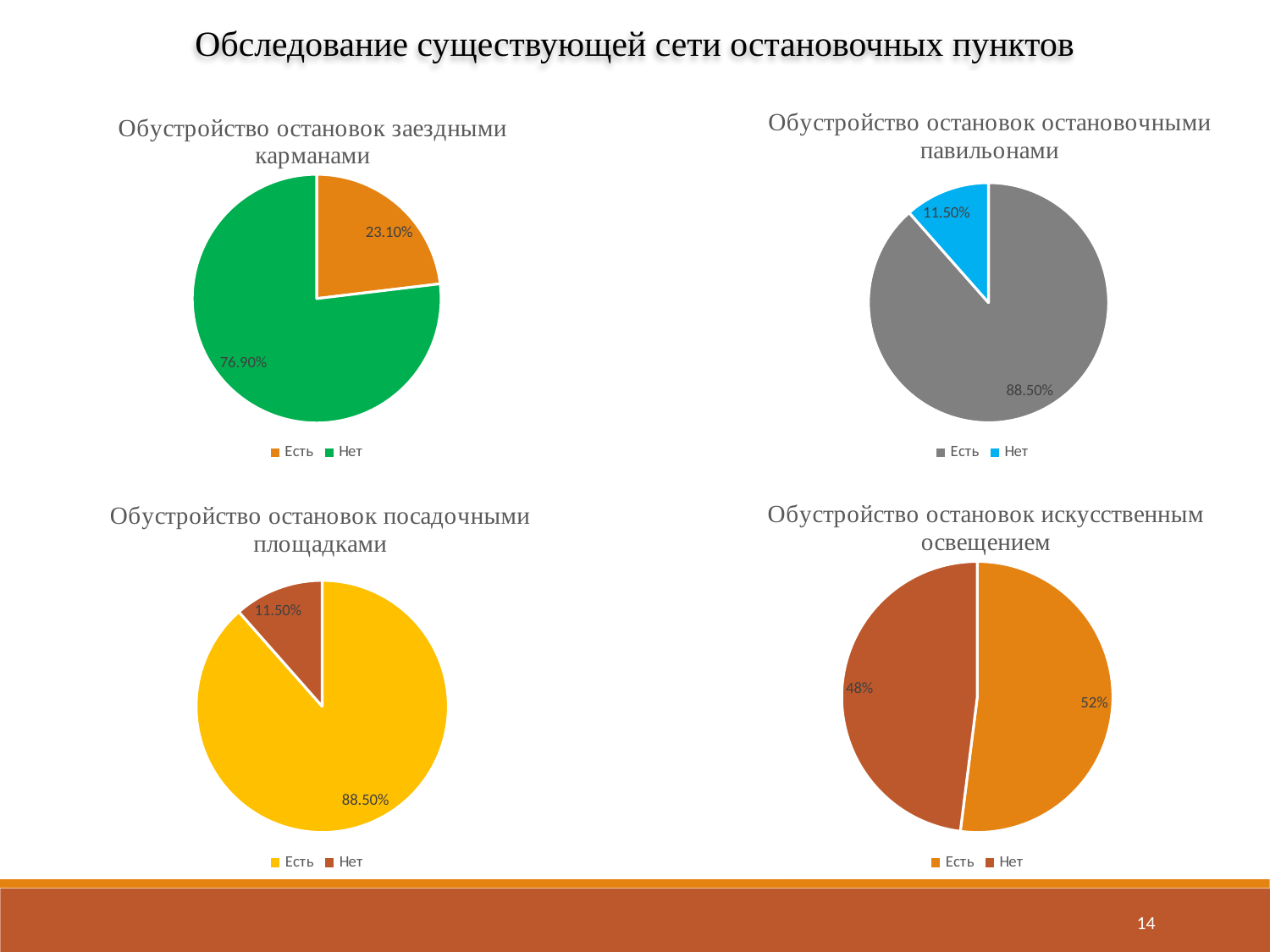
In the chart titled "Обустройство остановок заездными карманами", which category has the smaller share? Есть In the chart titled "Обустройство остановок искусственным освещением", what is the difference between the "Есть" and "Нет" shares? 4% In the chart titled "Обустройство остановок остановочными павильонами", what is the share for "Есть"? 88.50% How many charts are shown on the slide? 4 In the chart titled "Обустройство остановок заездными карманами", what is the share for "Нет"? 76.90% In the chart titled "Обустройство остановок заездными карманами", what is the share for "Есть"? 23.10% In the chart titled "Обустройство остановок заездными карманами", what is the difference between the "Нет" and "Есть" shares? 53.80% In the chart titled "Обустройство остановок искусственным освещением", what is the share for "Есть"? 52% In the chart titled "Обустройство остановок остановочными павильонами", what is the share for "Нет"? 11.50% What type of chart is the one titled "Обустройство остановок посадочными площадками"? Pie chart In the chart titled "Обустройство остановок искусственным освещением", which category has the larger share? Есть In the chart titled "Обустройство остановок посадочными площадками", what is the share for "Нет"? 11.50%